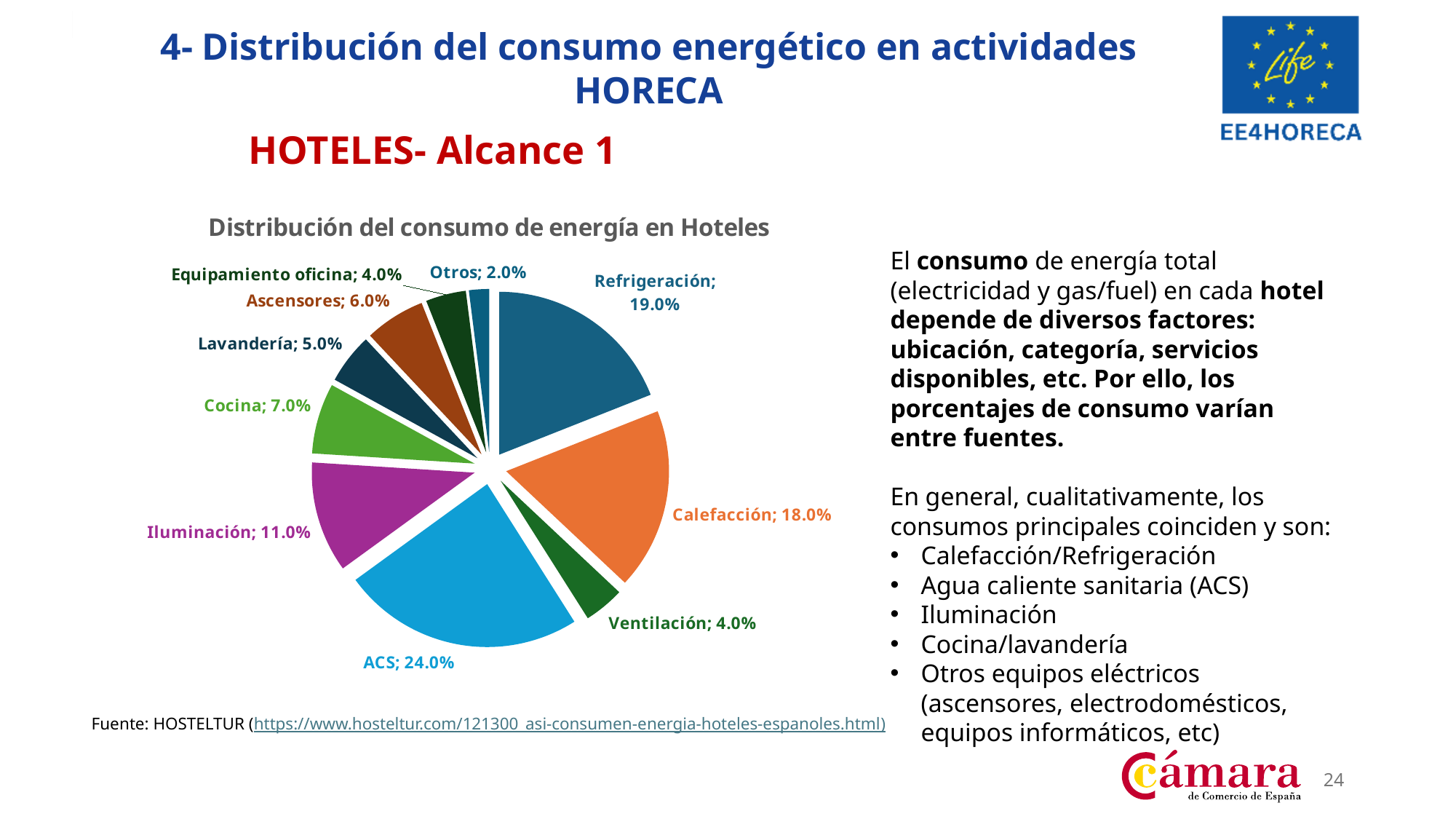
What is the value shown for Refrigeración in the pie chart? 19.0% Which is larger, the share for Cocina or the share for Lavandería? Cocina What percentage is shown for Iluminación? 11.0% What is the combined share of Refrigeración and Calefacción? 37.0% How many categories are shown in the pie chart? 10 What is the title of the chart? Distribución del consumo de energía en Hoteles Which category has the smallest slice of the pie chart? Otros Which category has the largest slice of the pie chart? ACS Which two categories both have a share of 4.0%? Equipamiento oficina and Ventilación What is the difference between the shares of ACS and Calefacción? 6.0% What share of energy consumption does ACS account for in the pie chart? 24.0% What type of chart is shown on the slide? Pie chart